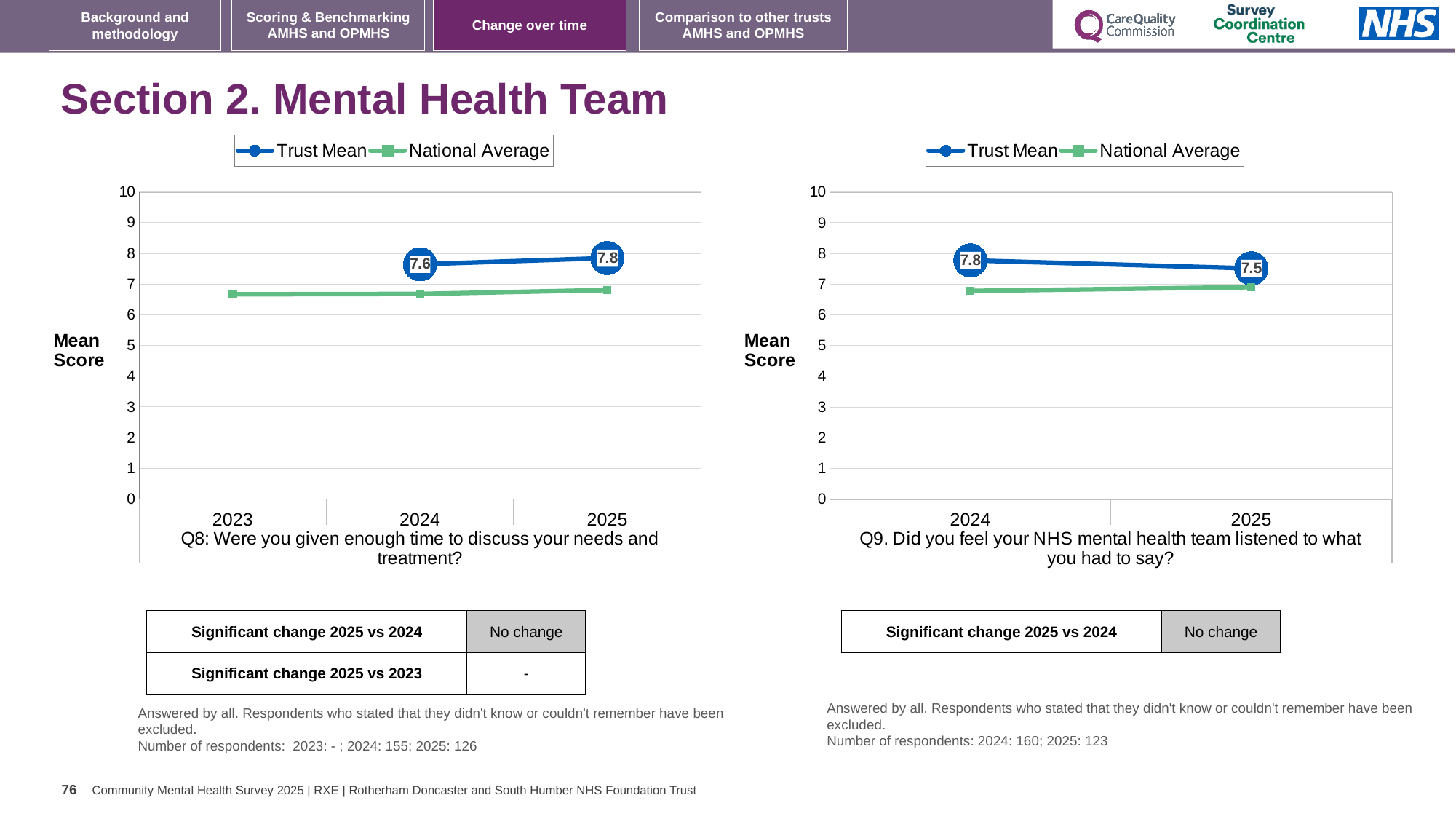
In the Q9 chart on the right, what is the difference between the Trust Mean in 2024 and in 2025? 0.3 In the Q9 chart on the right, what is the Trust Mean score for 2024? 7.8 In the Q8 chart on the left, what is the Trust Mean score for 2024? 7.6 What type of chart is the Q8 chart on the left? line chart In the Q9 chart on the right, which series has the higher value in 2025, Trust Mean or National Average? Trust Mean In the Q8 chart on the left, what is the Trust Mean score for 2025? 7.8 In the Q8 chart on the left, is the National Average for 2025 greater or less than 7? less How many series does the legend of the Q9 chart on the right list? 2 In the Q8 chart on the left, does the Trust Mean rise or fall from 2024 to 2025? rise In the Q9 chart on the right, does the Trust Mean rise or fall from 2024 to 2025? fall In the Q9 chart on the right, what is the Trust Mean score for 2025? 7.5 In the Q8 chart on the left, by how much did the Trust Mean change from 2024 to 2025? 0.2